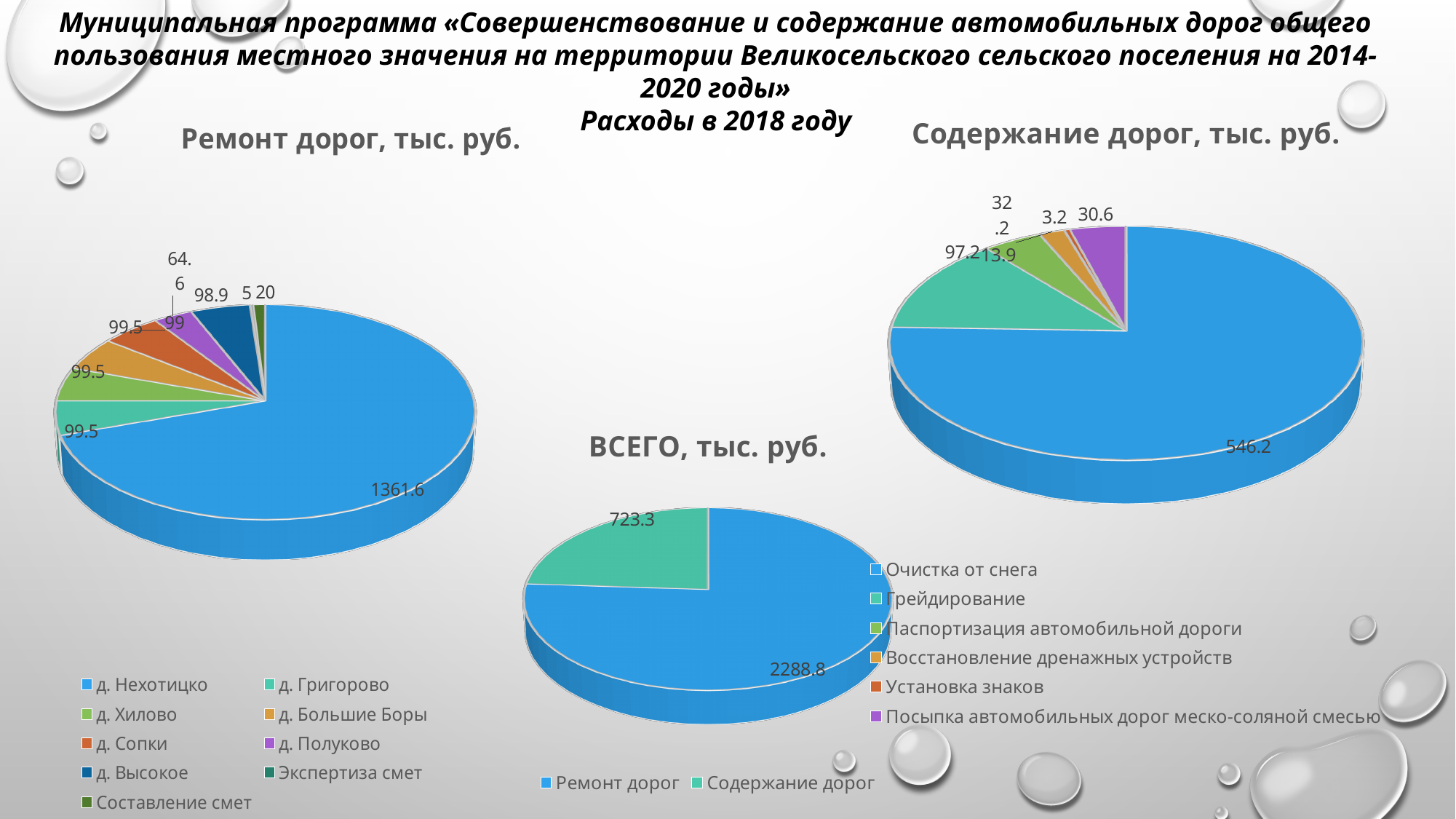
On the chart titled «Ремонт дорог, тыс. руб.», what is the value for д. Нехотицко? 1361.6 On the chart titled «Содержание дорог, тыс. руб.», how many categories does the legend list? 6 On the chart titled «Содержание дорог, тыс. руб.», which category has the smallest value? Установка знаков On the chart titled «ВСЕГО, тыс. руб.», which is larger: Ремонт дорог or Содержание дорог? Ремонт дорог On the chart titled «ВСЕГО, тыс. руб.», how many entries does the legend list? 2 On the chart titled «ВСЕГО, тыс. руб.», what is the value for Ремонт дорог? 2288.8 On the chart titled «ВСЕГО, тыс. руб.», what is the value for Содержание дорог? 723.3 On the chart titled «Содержание дорог, тыс. руб.», what is the value for Очистка от снега? 546.2 On the chart titled «ВСЕГО, тыс. руб.», what is the difference between Ремонт дорог and Содержание дорог? 1565.5 On the chart titled «Ремонт дорог, тыс. руб.», which category has the largest value? д. Нехотицко On the chart titled «Содержание дорог, тыс. руб.», what is the value for Грейдирование? 97.2 What kind of chart is the chart titled «ВСЕГО, тыс. руб.»? Pie chart